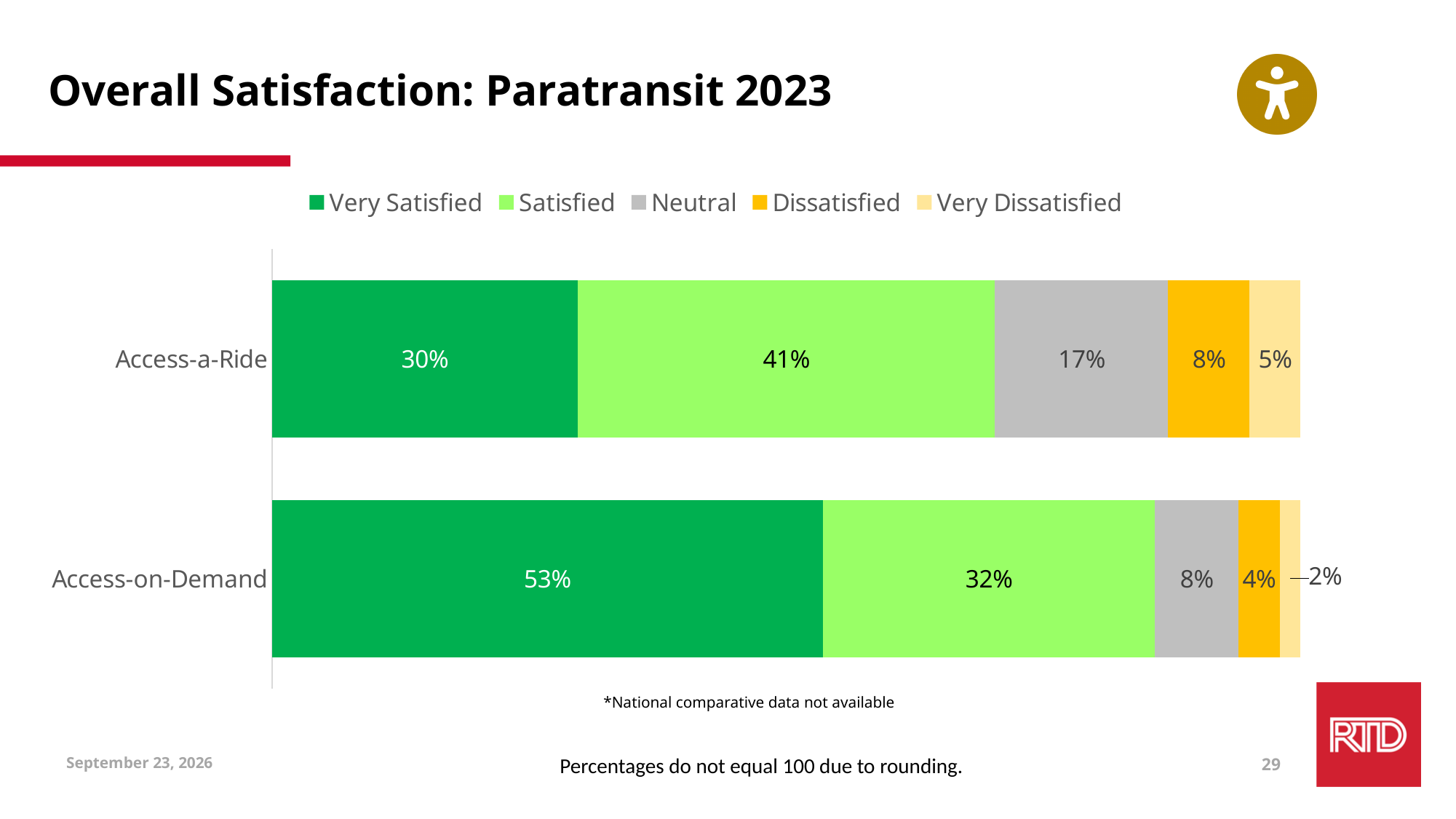
What percentage of Access-a-Ride respondents were Very Satisfied? 30% What is the Very Dissatisfied value for Access-on-Demand? 2% Which service has the higher Very Satisfied percentage? Access-on-Demand What is the Neutral value for Access-a-Ride? 17% What percentage of Access-on-Demand respondents were Satisfied? 32% Which service has the higher Neutral percentage? Access-a-Ride Which response category is the smallest for Access-on-Demand? Very Dissatisfied What is the difference between the Very Satisfied percentages for Access-on-Demand and Access-a-Ride? 23 percentage points What kind of chart is shown on the slide? Stacked bar chart How many series does the legend list? 5 Which response category is the largest for Access-a-Ride? Satisfied What is the difference between the Dissatisfied percentages for Access-a-Ride and Access-on-Demand? 4 percentage points